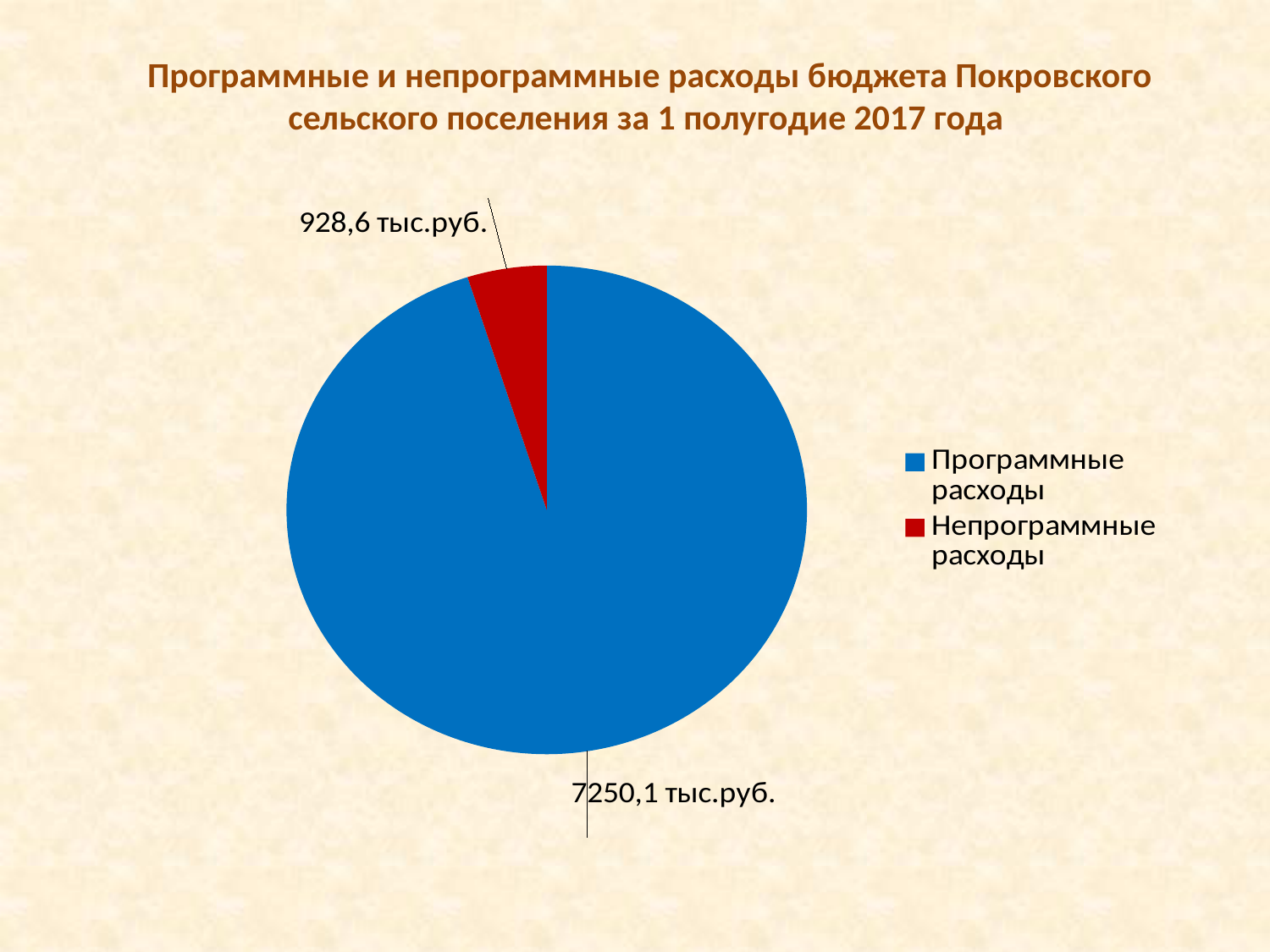
What is the value for Программные расходы? 7250,1 тыс.руб. What kind of chart is shown on the slide? Pie chart What is the value for Непрограммные расходы? 928,6 тыс.руб. How many entries does the legend list? 2 What is the difference between Программные расходы and Непрограммные расходы? 6321,5 тыс.руб. What colour is the slice for Непрограммные расходы? Red What is the title of the chart? Программные и непрограммные расходы бюджета Покровского сельского поселения за 1 полугодие 2017 года How many slices does the pie chart have? 2 Which is larger, Программные расходы or Непрограммные расходы? Программные расходы Which category has the largest slice of the pie? Программные расходы Which category has the smallest slice of the pie? Непрограммные расходы